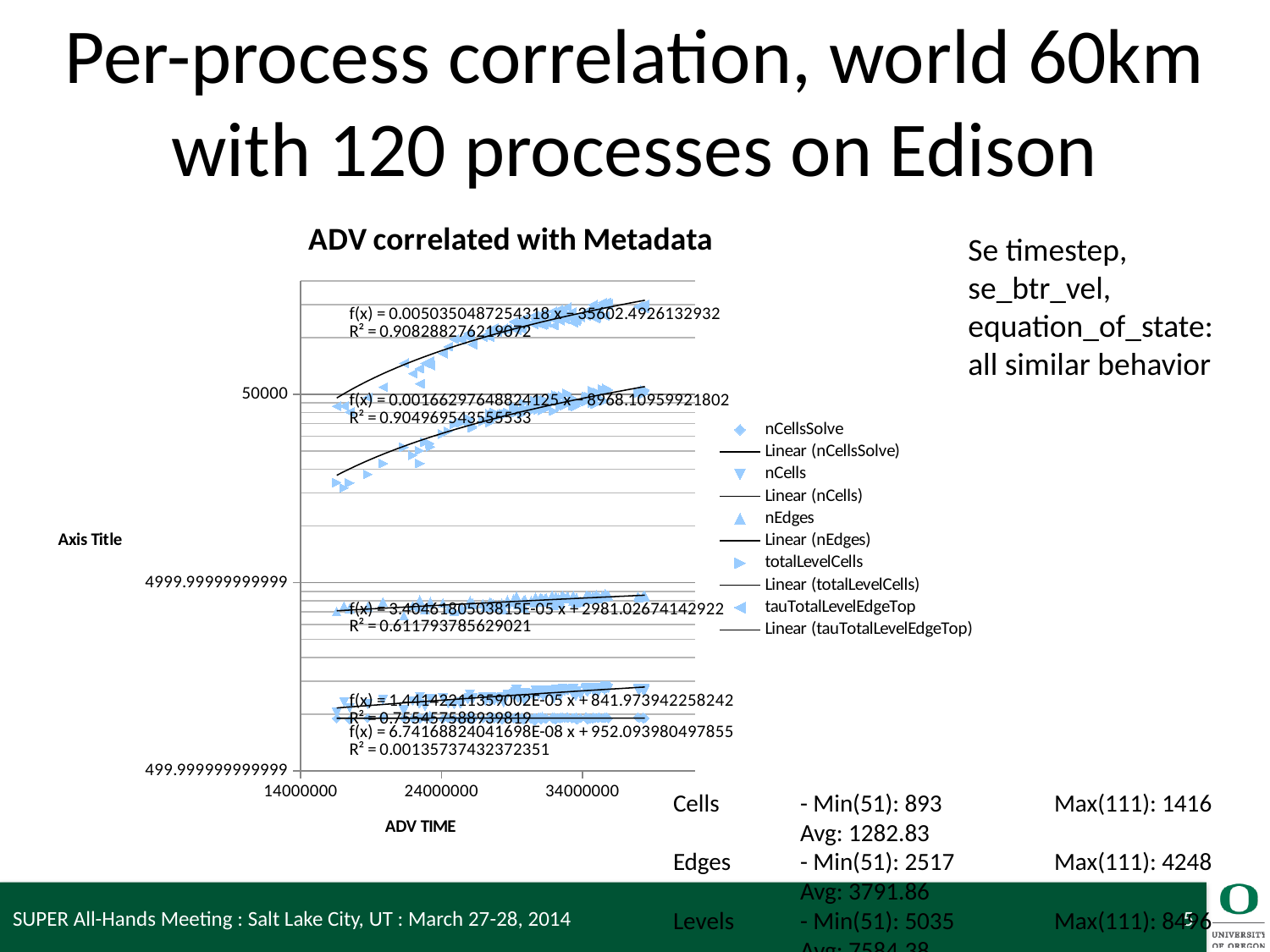
How many entries does the chart's legend list? 10 What is the intercept printed in the trendline equation whose R² is 0.611793785629021? 2981.02674142922 What is the title of the chart on the slide? ADV correlated with Metadata What is the highest R² value printed on the chart? 0.908288276219072 Are the points in the lowest cluster on the chart greater or less than the 4999.99999999999 y-axis tick? less What is the lowest R² value printed on the chart? 0.00135737432372351 Do the plotted values generally rise or fall as ADV TIME increases? rise What kind of chart is shown on the slide? scatter chart What R² value is printed for the topmost trendline on the chart? 0.908288276219072 What is the slope printed in the equation of the topmost trendline? 0.0050350487254318 What is the label on the chart's x axis? ADV TIME Which is larger: the R² of the topmost trendline (0.908288276219072) or the R² of the bottommost trendline (0.00135737432372351)? the topmost trendline